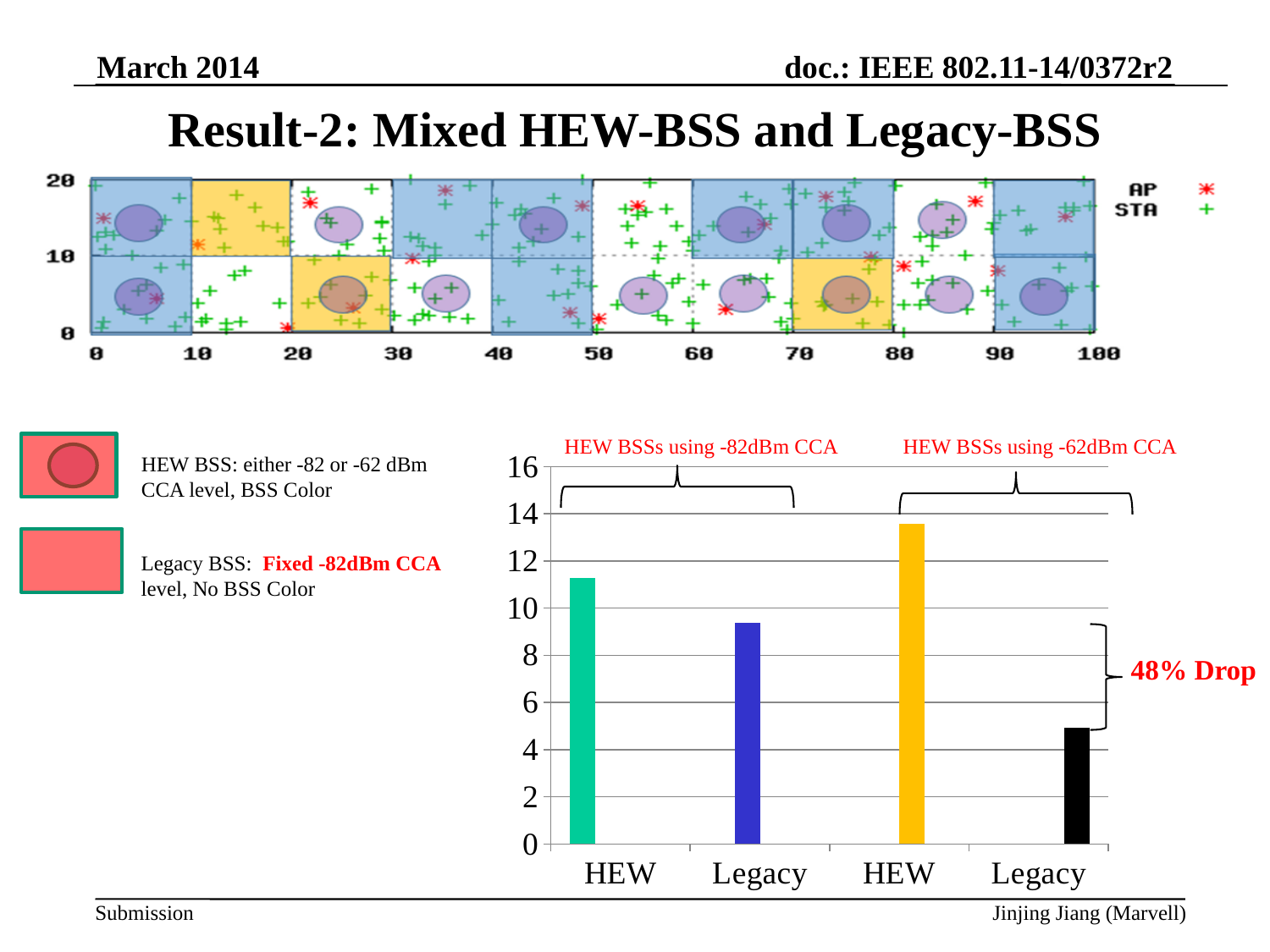
What percentage drop is annotated next to the Legacy bar in the 'HEW BSSs using -62dBm CCA' group? 48% Drop What is the maximum value shown on the vertical axis of the bar chart? 16 In the bar chart, which bar is the lowest? Legacy (HEW BSSs using -62dBm CCA) In the bar chart, is the value for HEW in the 'HEW BSSs using -62dBm CCA' group greater or less than 12? greater In the bar chart, is the value for Legacy in the 'HEW BSSs using -82dBm CCA' group greater or less than 10? less How many bars are plotted in the bar chart? 4 In the bar chart, within the 'HEW BSSs using -82dBm CCA' group, which is larger: HEW or Legacy? HEW In the bar chart, is the value for Legacy in the 'HEW BSSs using -62dBm CCA' group greater or less than 6? less In the bar chart, which bar is the highest? HEW (HEW BSSs using -62dBm CCA) What kind of chart is shown at the bottom right of the slide? bar chart In the bar chart, which Legacy bar is larger: the one in the -82dBm CCA group or the one in the -62dBm CCA group? the one in the -82dBm CCA group